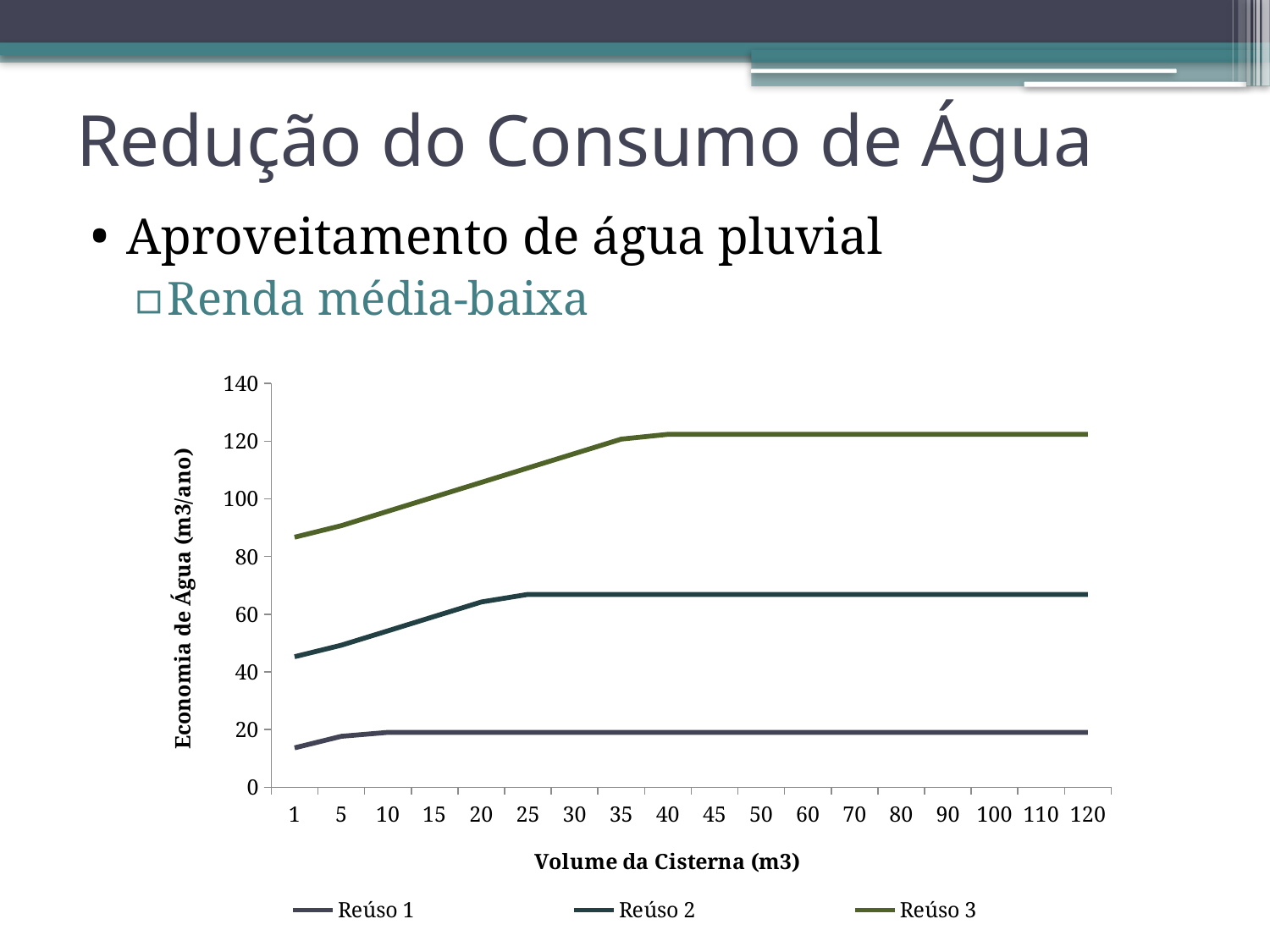
How many series does the legend list? 3 At a cistern volume of 30, which is larger: Reúso 2 or Reúso 3? Reúso 3 Do the values for Reúso 3 rise or fall between cistern volumes of 1 and 40? rise How many points are on the x axis (Volume da Cisterna)? 18 Which series has the lowest values across the chart? Reúso 1 What is the label of the y axis? Economia de Água (m3/ano) Is the value for Reúso 3 at a cistern volume of 120 greater or less than 100? greater What kind of chart is shown on the slide? line chart Which series has the highest values across the chart? Reúso 3 Is the value for Reúso 3 at a cistern volume of 1 greater or less than 80? greater Is the value for Reúso 1 at a cistern volume of 1 greater or less than 20? less